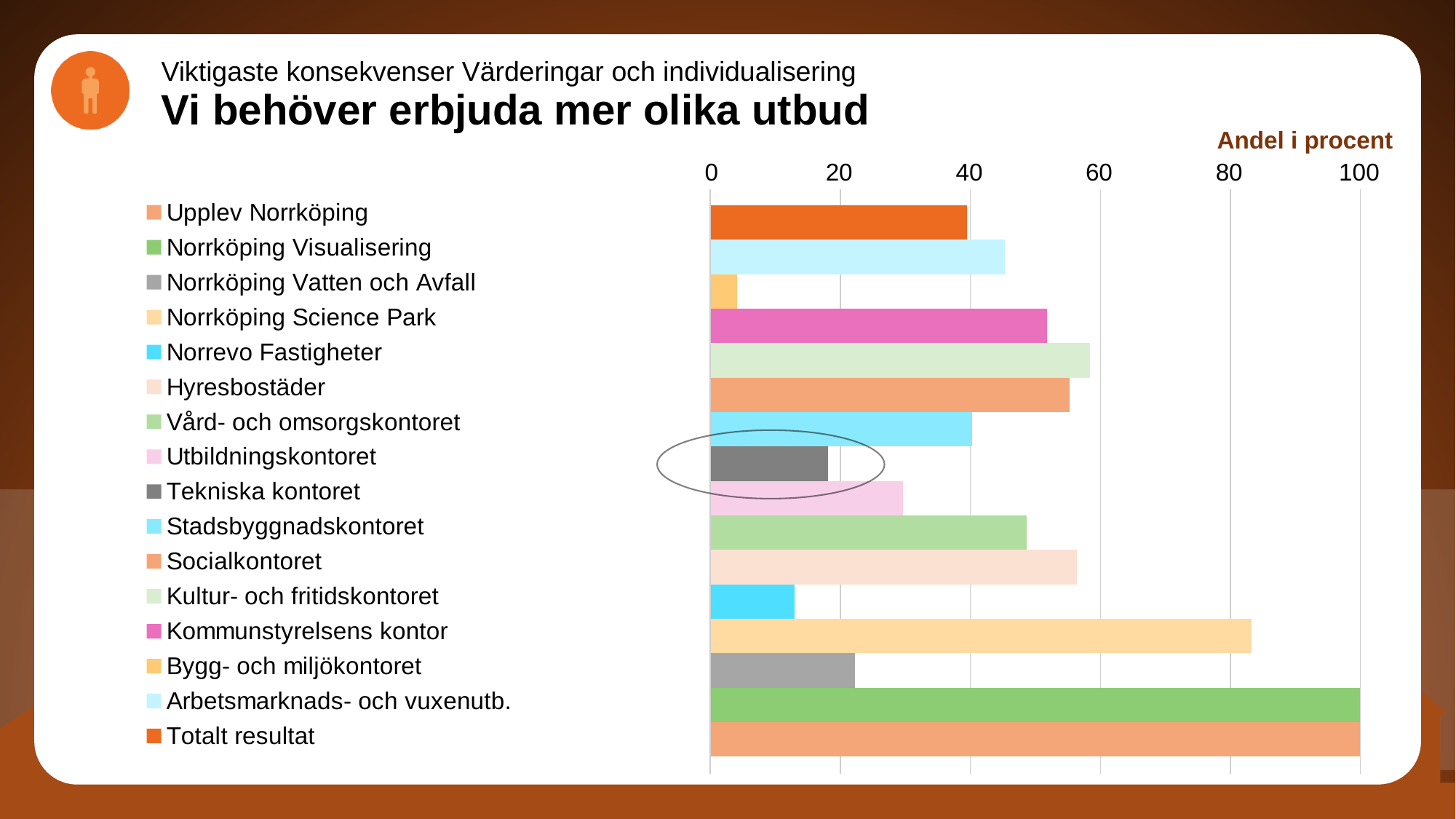
Which category's bar is circled on the chart? Tekniska kontoret Is the value for Norrevo Fastigheter greater or less than 20? less What kind of chart is shown on the slide? bar chart Which is larger, the value for Norrköping Science Park or the value for Hyresbostäder? Norrköping Science Park Which is larger, the value for Kommunstyrelsens kontor or the value for Norrevo Fastigheter? Kommunstyrelsens kontor What is the label shown above the horizontal axis of the chart? Andel i procent Is the value for Norrköping Science Park greater or less than 80? greater Is the value for Totalt resultat greater or less than 60? less How many categories does the legend list? 16 Which category has the lowest value? Bygg- och miljökontoret